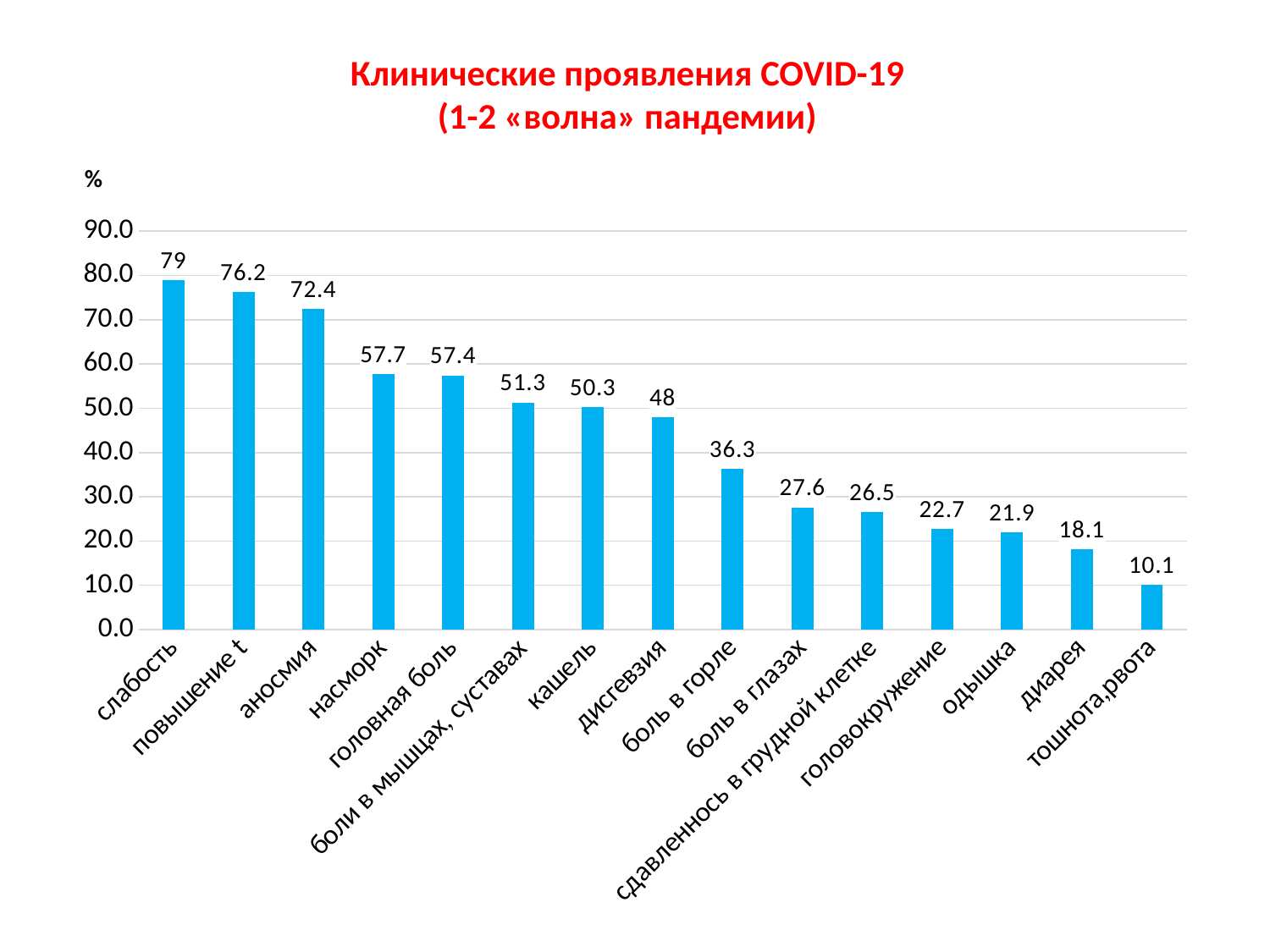
What is the difference between the values for слабость and аносмия? 6.6 Which category has the highest value? слабость What is the value for кашель? 50.3 What is the difference between the values for боль в горле and диарея? 18.2 How many categories are shown on the chart? 15 Which category has the lowest value? тошнота,рвота What kind of chart is shown on the slide? bar chart Do the values rise or fall from left to right along the x axis? fall What is the value for одышка? 21.9 What is the value for слабость? 79 Which is larger, the value for насморк or the value for дисгевзия? насморк Is the value for головокружение greater or less than 30.0? less